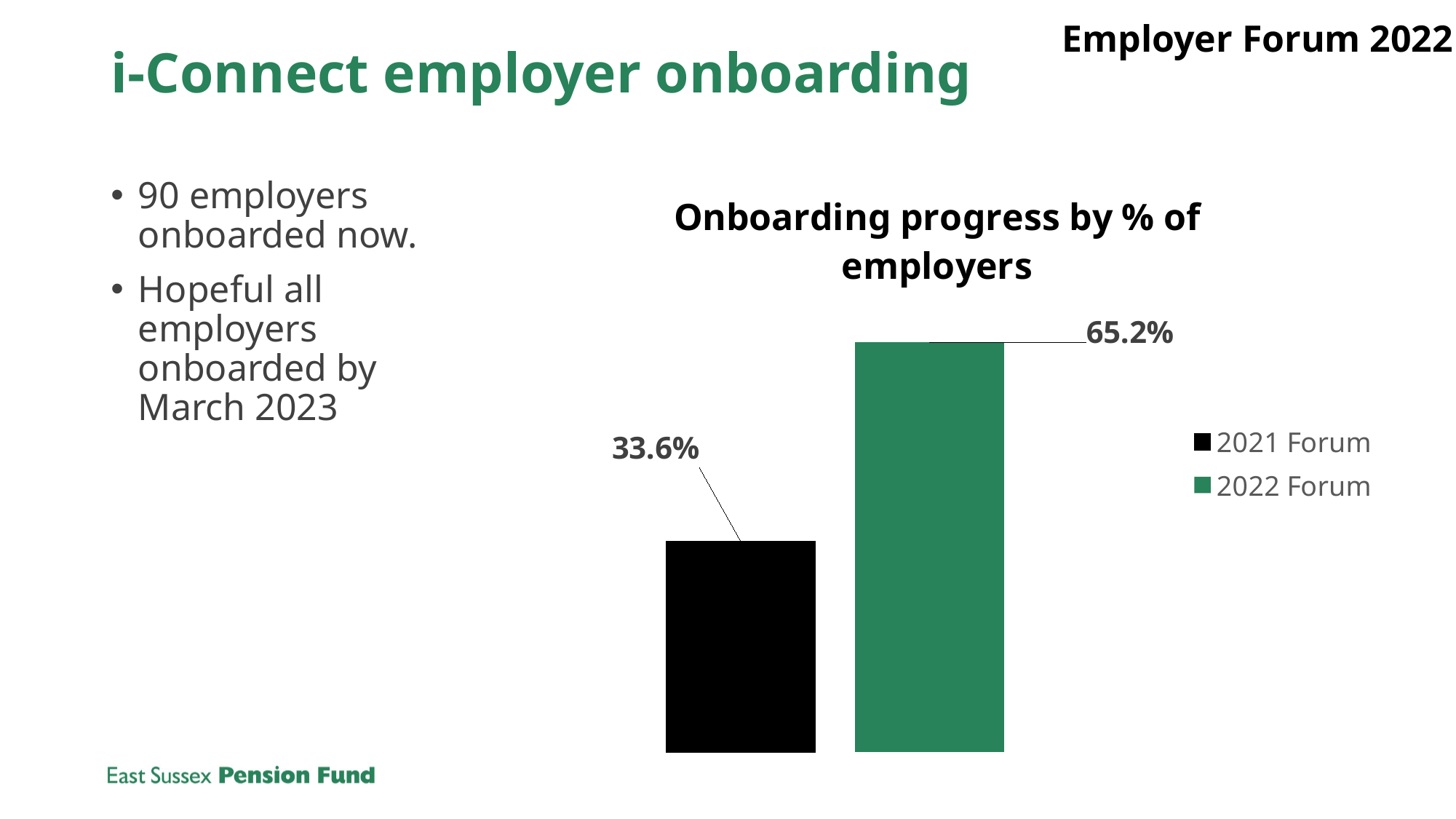
What is the value for 2022 Forum in the chart? 65.2% How many series does the legend list? 2 What kind of chart is shown on the slide? Bar chart What colour is the bar for 2022 Forum? Green Which is larger, the value for 2021 Forum or the value for 2022 Forum? 2022 Forum How many bars are plotted in the chart? 2 Did the onboarding percentage rise or fall from the 2021 Forum to the 2022 Forum? Rise What is the title of the chart? Onboarding progress by % of employers Which series has the highest value in the chart? 2022 Forum Which series has the lowest value in the chart? 2021 Forum What is the value for 2021 Forum in the chart? 33.6% What is the difference between the 2022 Forum and 2021 Forum values? 31.6%